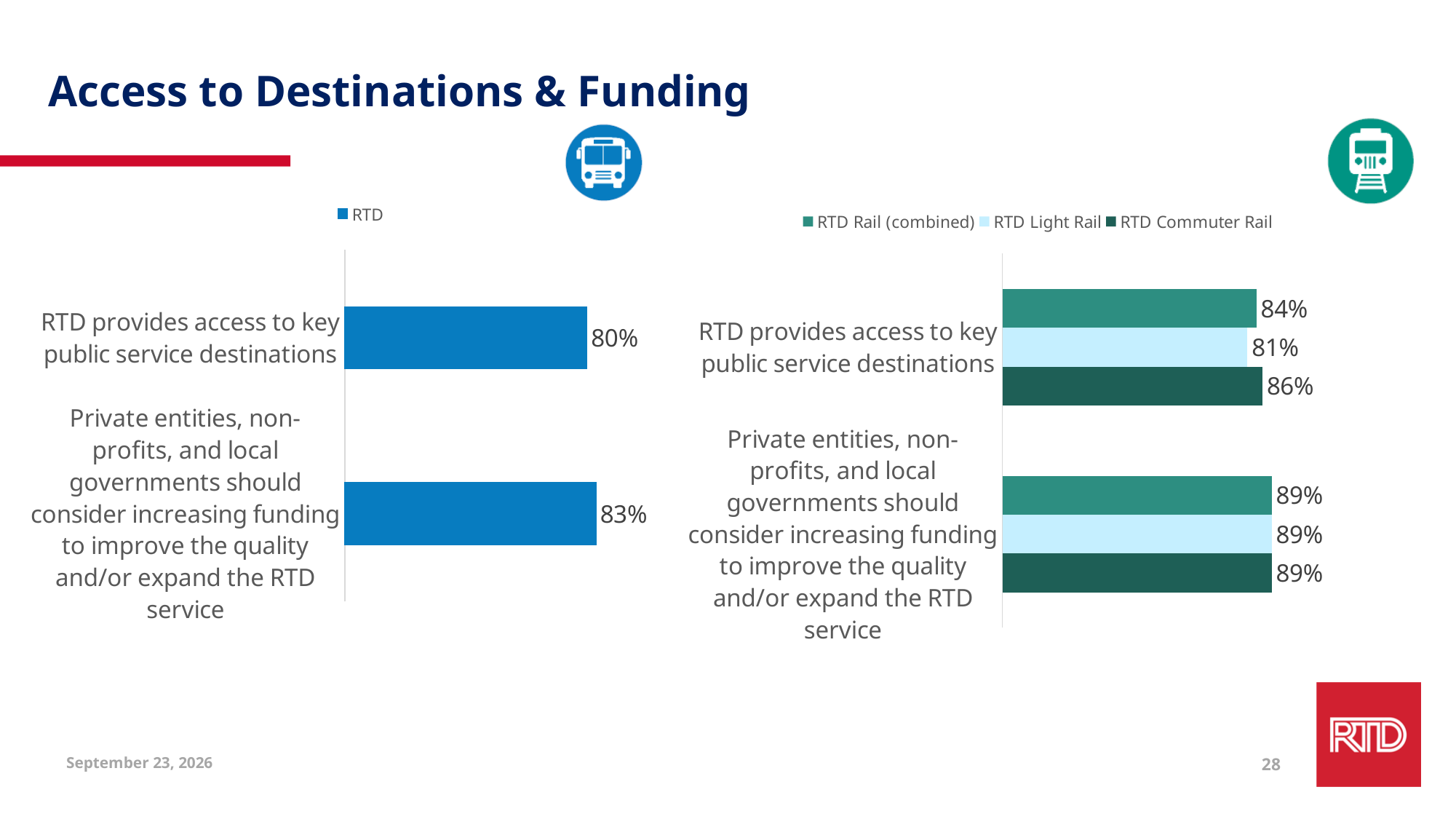
In the right chart (rail), what is the difference between RTD Commuter Rail and RTD Light Rail for 'RTD provides access to key public service destinations'? 5% In the right chart (rail), what is the RTD Rail (combined) value for the statement about increasing funding? 89% In the right chart (rail), what is the RTD Commuter Rail value for 'RTD provides access to key public service destinations'? 86% In the right chart (rail), which series has the highest value for 'RTD provides access to key public service destinations'? RTD Commuter Rail In the right chart (rail), how many series does the legend list? 3 In the left chart (bus), what is the value for the statement that private entities, non-profits, and local governments should consider increasing funding? 83% In the right chart (rail), what is the RTD Light Rail value for 'RTD provides access to key public service destinations'? 81% In the right chart (rail), which is larger for the funding statement: RTD Light Rail or RTD Commuter Rail? They are equal (89%) In the left chart (bus), how many series does the legend list? 1 What type of chart is the right chart (rail)? Bar chart In the left chart (bus), what is the difference between the two bars? 3% In the left chart (bus), what is the value for 'RTD provides access to key public service destinations'? 80%